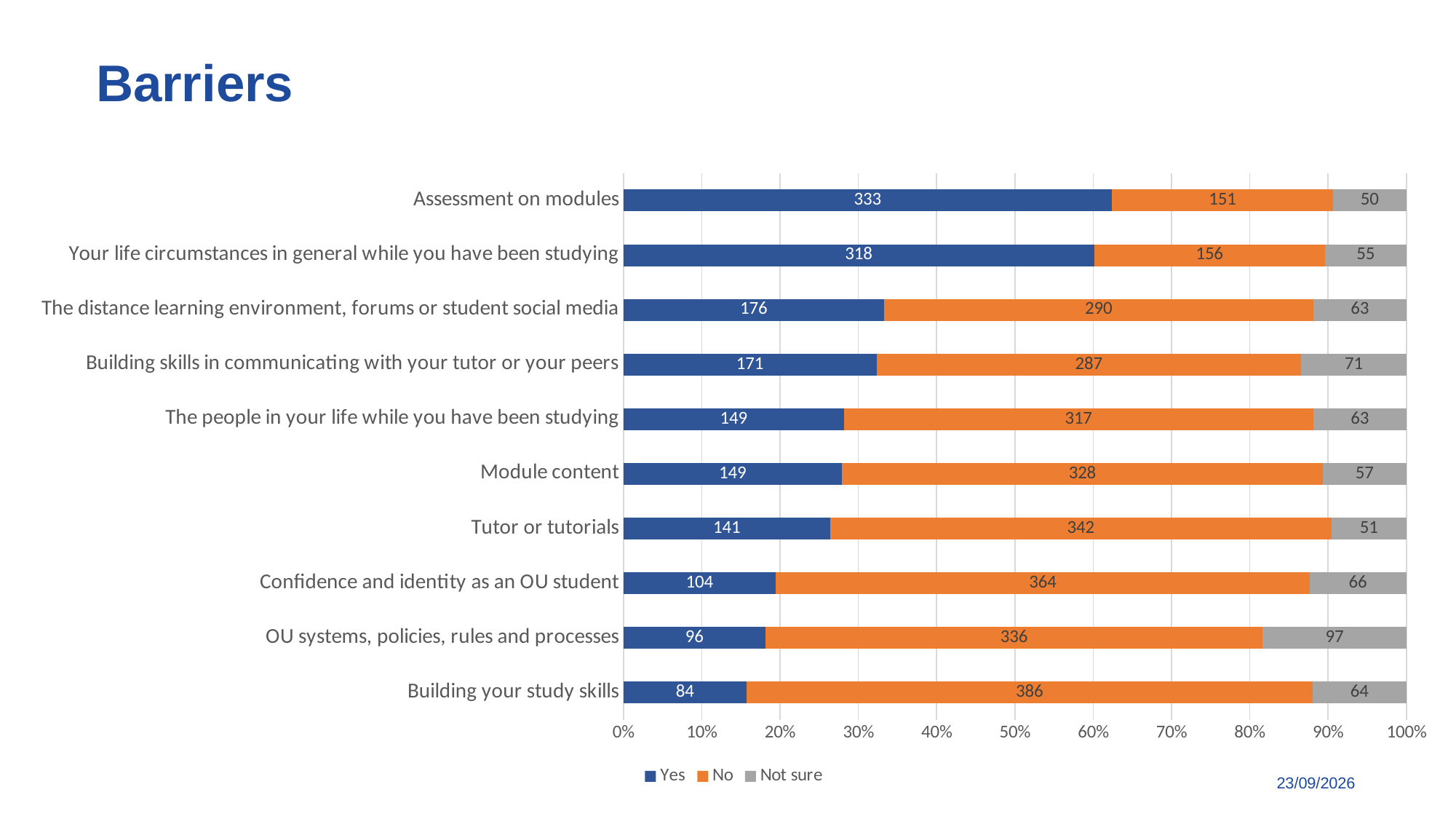
What is the total of the stacked bar for 'Assessment on modules'? 534 What is the difference between the 'Yes' values for 'Assessment on modules' and 'Building your study skills'? 249 Is the 'Yes' share of the bar for 'Assessment on modules' greater or less than 50%? greater Which category has the highest 'Yes' value? Assessment on modules Which is larger: the 'No' value for 'Tutor or tutorials' or the 'No' value for 'Module content'? Tutor or tutorials What is the 'Not sure' value for 'OU systems, policies, rules and processes'? 97 How many categories (barriers) are plotted on the chart? 10 What kind of chart is shown on the slide? Stacked bar chart Which category has the lowest 'Yes' value? Building your study skills What is the 'Yes' value for 'Assessment on modules'? 333 What is the 'No' value for 'Building your study skills'? 386 How many series does the legend list? 3